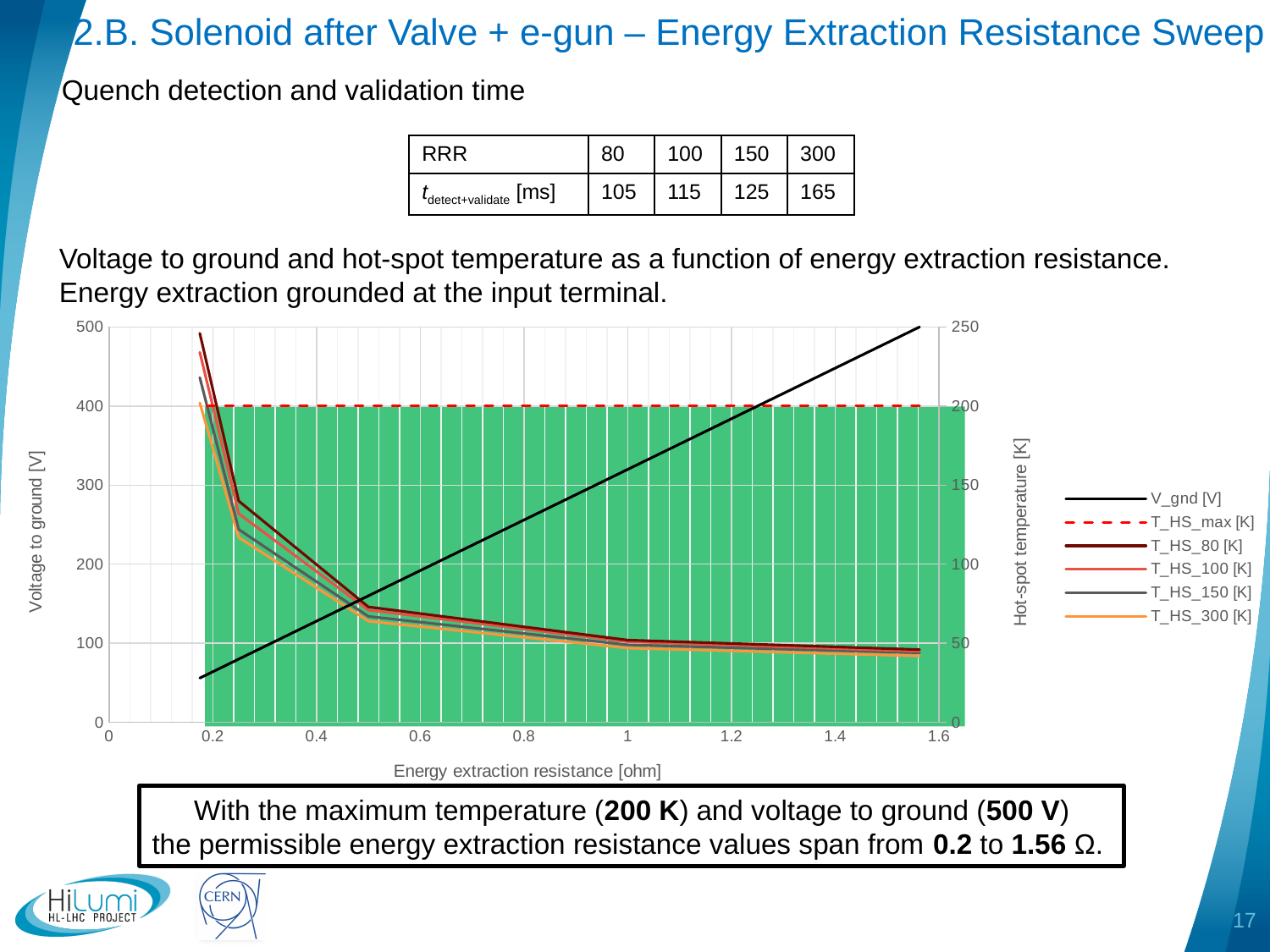
Is the V_gnd [V] value at 1.2 ohm greater or less than 300? greater What type of chart is shown on the slide? line chart At the left end of the chart (around 0.2 ohm), which is higher: T_HS_80 [K] or T_HS_300 [K]? T_HS_80 [K] What is the label of the x axis of the chart? Energy extraction resistance [ohm] Which series in the legend is drawn as a dashed line? T_HS_max [K] Does the V_gnd [V] series rise or fall as the energy extraction resistance increases? rises Does the T_HS_80 [K] series rise or fall as the energy extraction resistance increases? falls Is the V_gnd [V] value at 0.2 ohm greater or less than 100? less Is the T_HS_80 [K] value at 0.6 ohm greater or less than 100 on the right axis? less How many series does the chart legend list? 6 What constant hot-spot temperature value does the T_HS_max [K] line sit at on the right axis? 200 Among the T_HS_80, T_HS_100, T_HS_150 and T_HS_300 series, which is the highest at the left end of the chart? T_HS_80 [K]